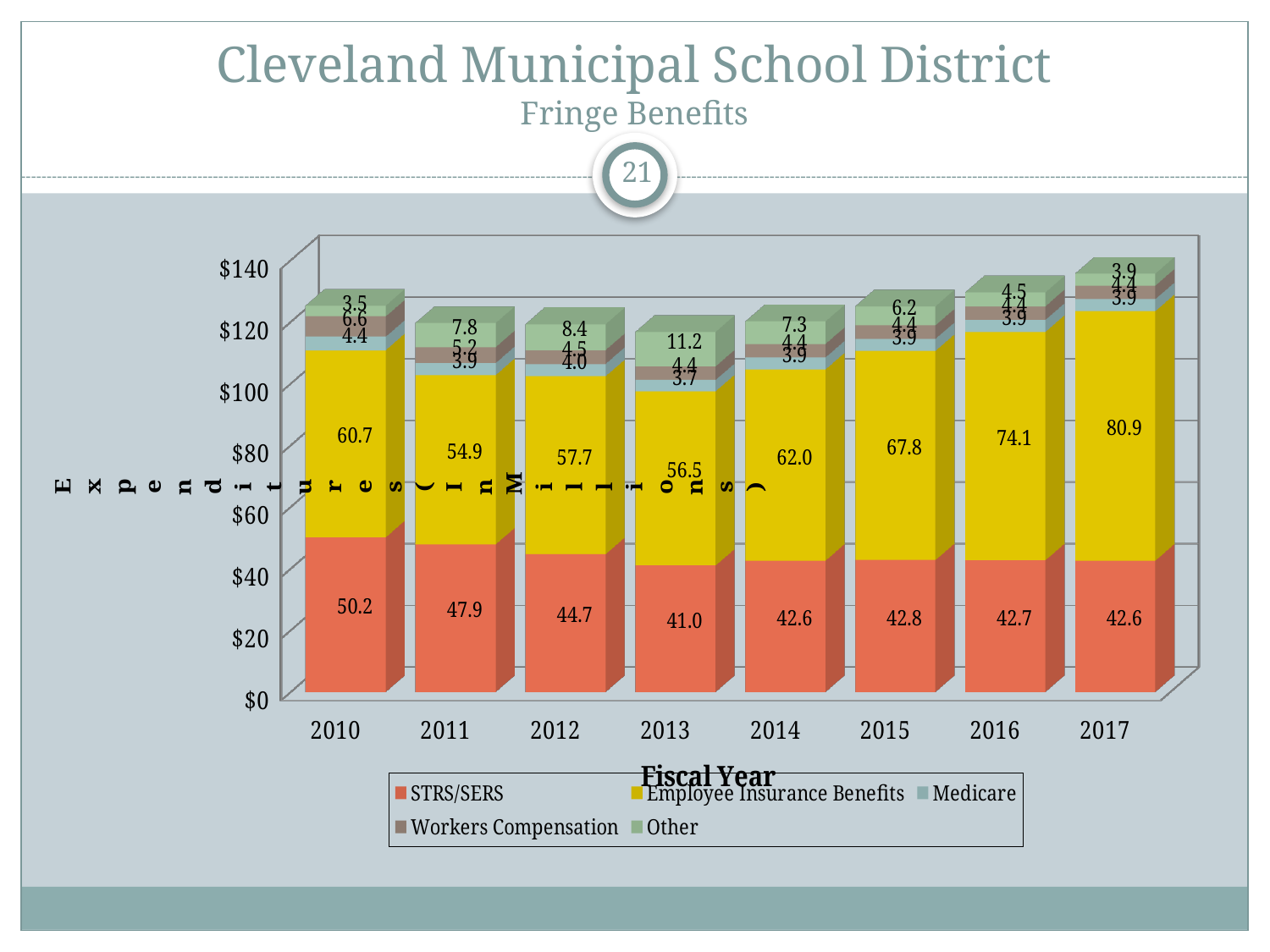
How many fiscal years are shown on the x axis? 8 How many series does the legend list? 5 What is the Employee Insurance Benefits value for 2017? 80.9 Is the total stacked bar for 2017 greater or less than $120? greater What is the STRS/SERS value for 2010? 50.2 What is the title of the x axis? Fiscal Year What kind of chart is shown on the slide? bar chart Which year has the larger STRS/SERS value, 2011 or 2012? 2011 In which fiscal year is the STRS/SERS value lowest? 2013 What is the difference between the Employee Insurance Benefits values for 2017 and 2010? 20.2 What is the Other value for 2013? 11.2 In which fiscal year is the Employee Insurance Benefits value highest? 2017